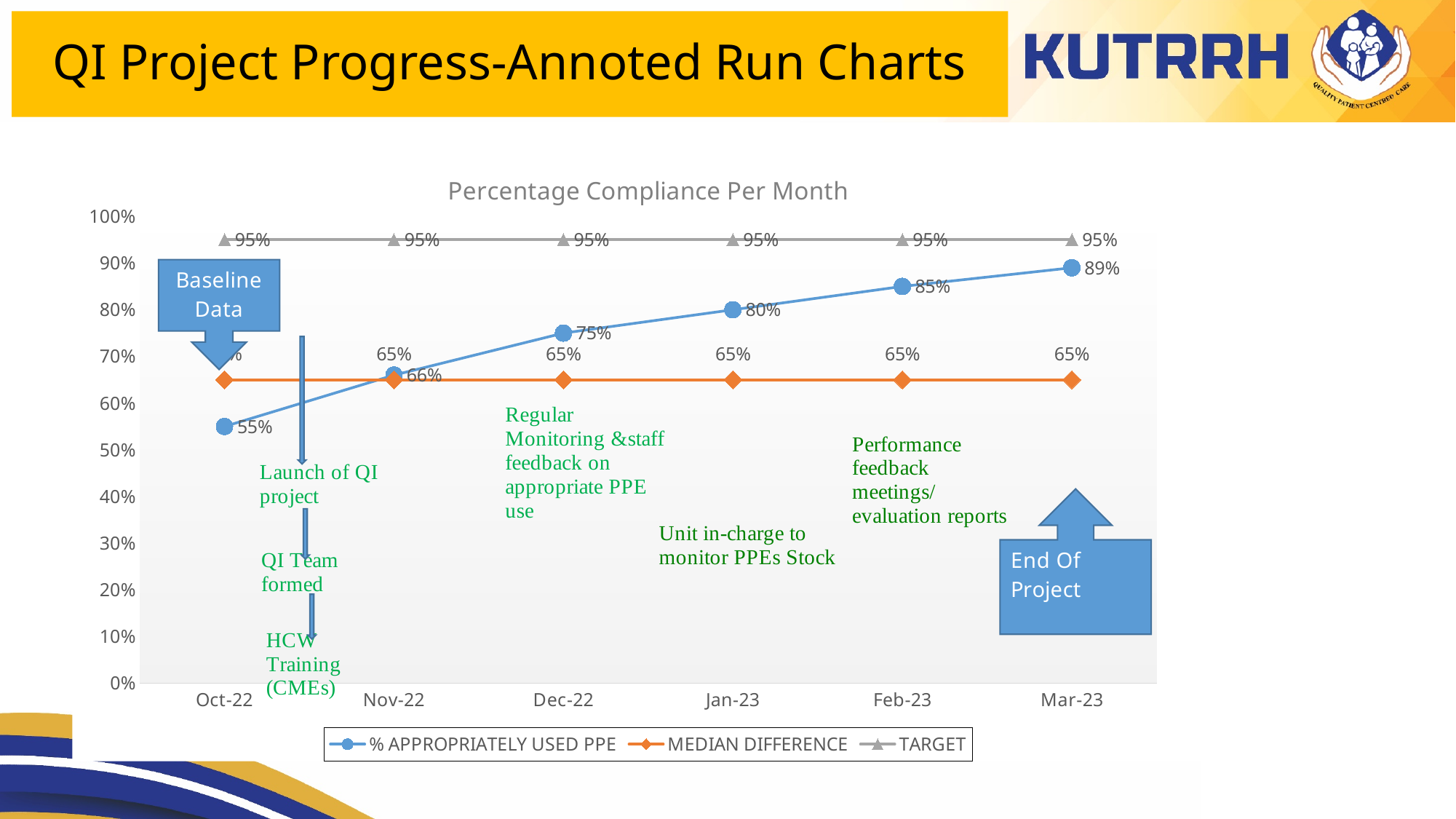
What is the difference between % APPROPRIATELY USED PPE in Mar-23 and Oct-22? 34% What is the value of % APPROPRIATELY USED PPE for Oct-22? 55% What type of chart is shown on the slide? Line chart What is the TARGET value for Jan-23? 95% Does % APPROPRIATELY USED PPE rise or fall from Oct-22 to Mar-23? Rise What is the MEDIAN DIFFERENCE value for Dec-22? 65% Which is larger in Feb-23: % APPROPRIATELY USED PPE or MEDIAN DIFFERENCE? % APPROPRIATELY USED PPE How many months are plotted along the x axis? 6 What is the title of the chart? Percentage Compliance Per Month In which month is % APPROPRIATELY USED PPE lowest? Oct-22 What is the value of % APPROPRIATELY USED PPE for Mar-23? 89% How many series does the legend list? 3